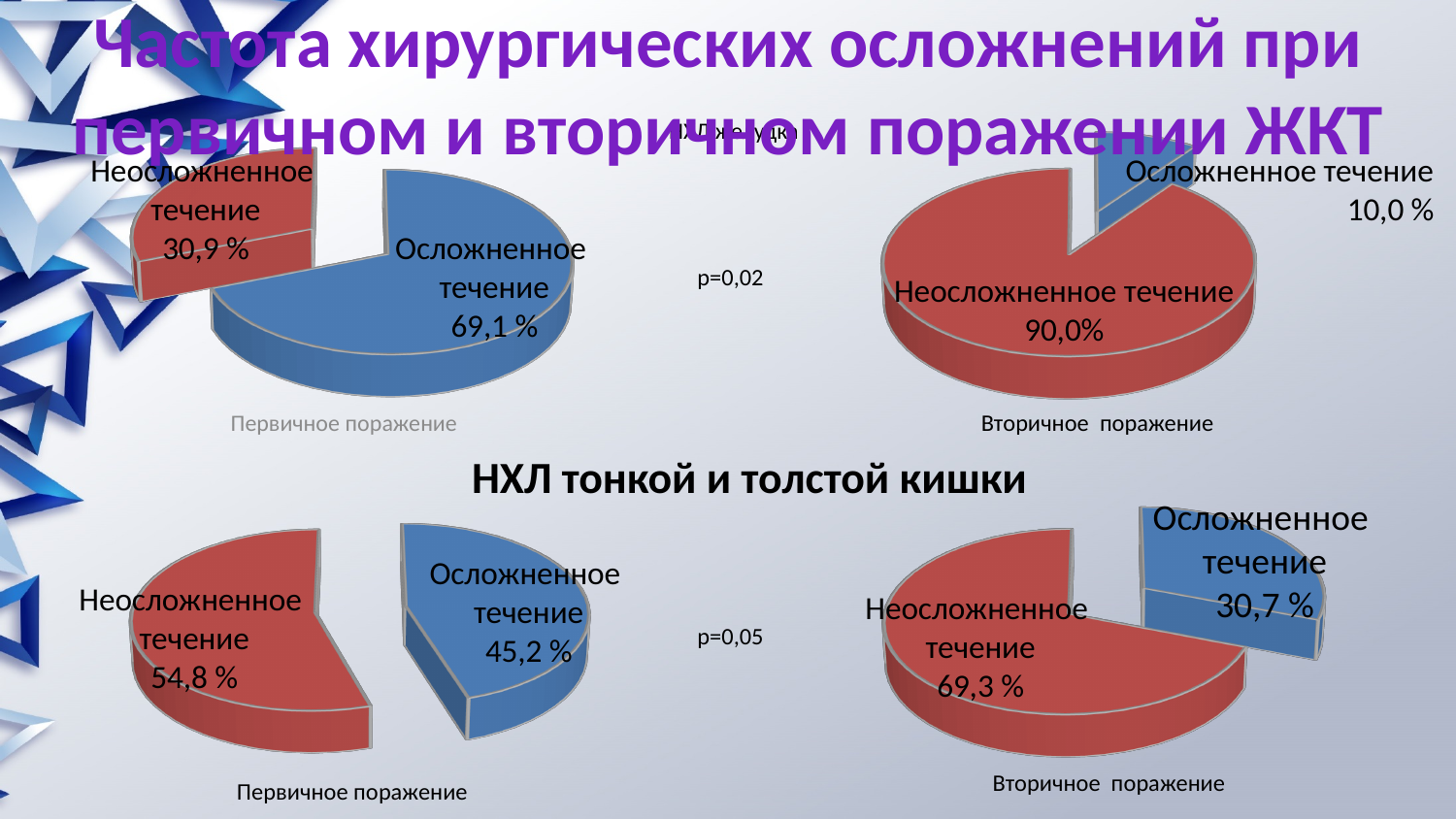
How many slices does the bottom-right pie chart (Вторичное поражение, НХЛ тонкой и толстой кишки) have? 2 In the bottom-left pie chart (Первичное поражение, НХЛ тонкой и толстой кишки), which is larger: Неосложненное течение or Осложненное течение? Неосложненное течение In the top-right pie chart (Вторичное поражение, top row), what is the share for Осложненное течение? 10,0 % In the top-left pie chart (Первичное поражение, top row), what is the share for Осложненное течение? 69,1 % In the top-left pie chart (Первичное поражение, top row), what is the share for Неосложненное течение? 30,9 % In the top-left pie chart (Первичное поражение, top row), which slice is the smallest? Неосложненное течение In the bottom-right pie chart (Вторичное поражение, НХЛ тонкой и толстой кишки), which slice is the largest? Неосложненное течение In the top-right pie chart (Вторичное поражение, top row), what is the difference between the Неосложненное течение and Осложненное течение shares? 80,0 % In the bottom-left pie chart (Первичное поражение, НХЛ тонкой и толстой кишки), what is the share for Неосложненное течение? 54,8 % In the bottom-right pie chart (Вторичное поражение, НХЛ тонкой и толстой кишки), what is the share for Осложненное течение? 30,7 % What type of chart is used for the bottom-left chart (Первичное поражение, НХЛ тонкой и толстой кишки)? Pie chart In the top-right pie chart (Вторичное поражение, top row), what is the share for Неосложненное течение? 90,0%